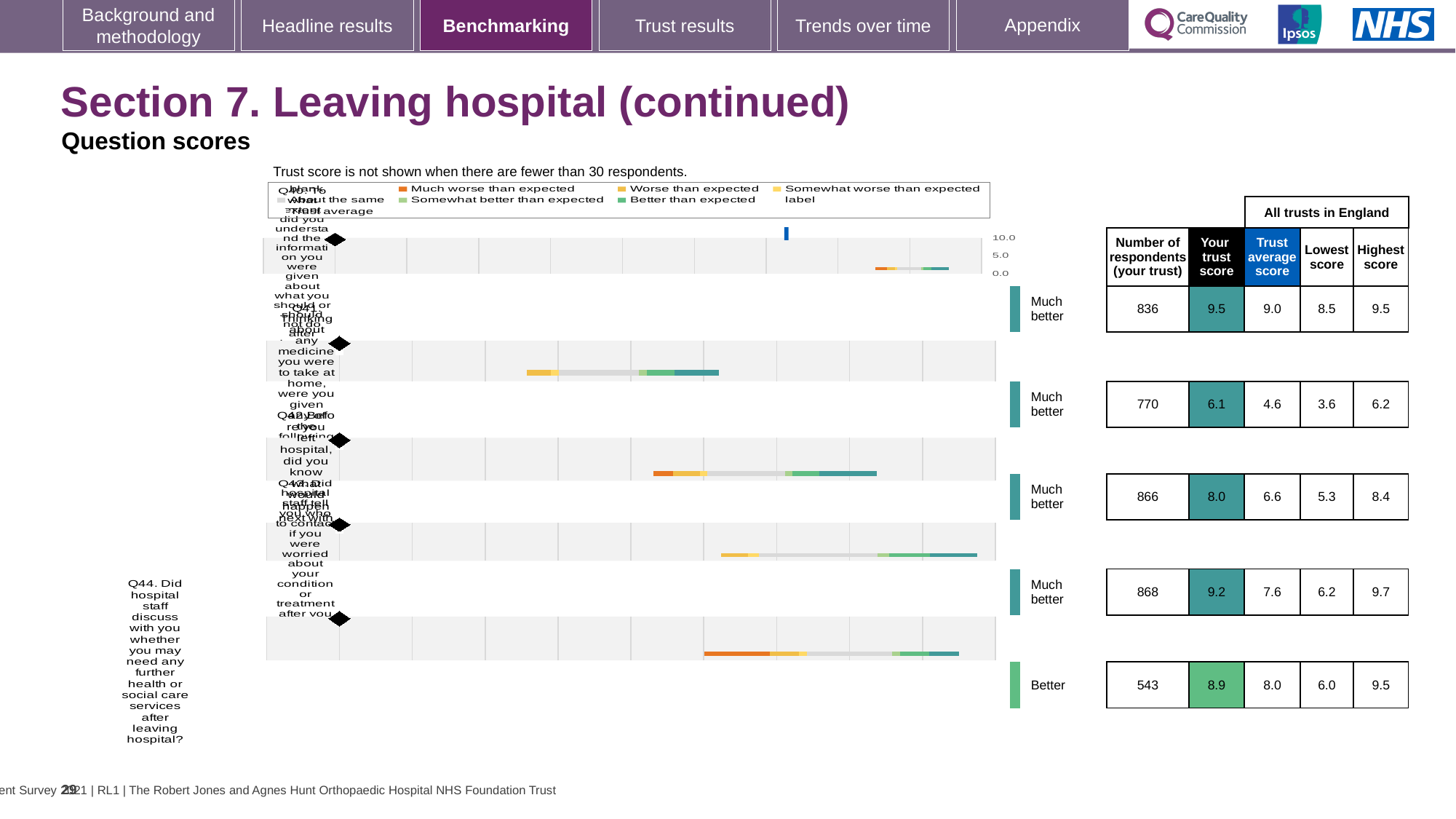
What is the difference between your trust score and the trust average score for Q44? 0.9 What is the largest number of respondents shown for any question row in the table? 868 What is the 'Your trust score' for the first question row at the top of the chart? 9.5 What is the 'Your trust score' for Q44 (Did hospital staff discuss with you whether you may need any further health or social care services after leaving hospital?)? 8.9 What benchmark rating is shown for Q44? Better What kind of chart is used to show the question scores? Bar chart How many question rows are shown in the chart? 5 For Q44, which is larger: your trust score or the trust average score? Your trust score What is the lowest score among all trusts in England for Q44? 6.0 How many respondents from your trust answered Q44? 543 What is the highest score among all trusts in England for Q44? 9.5 What is the trust average score for Q44? 8.0